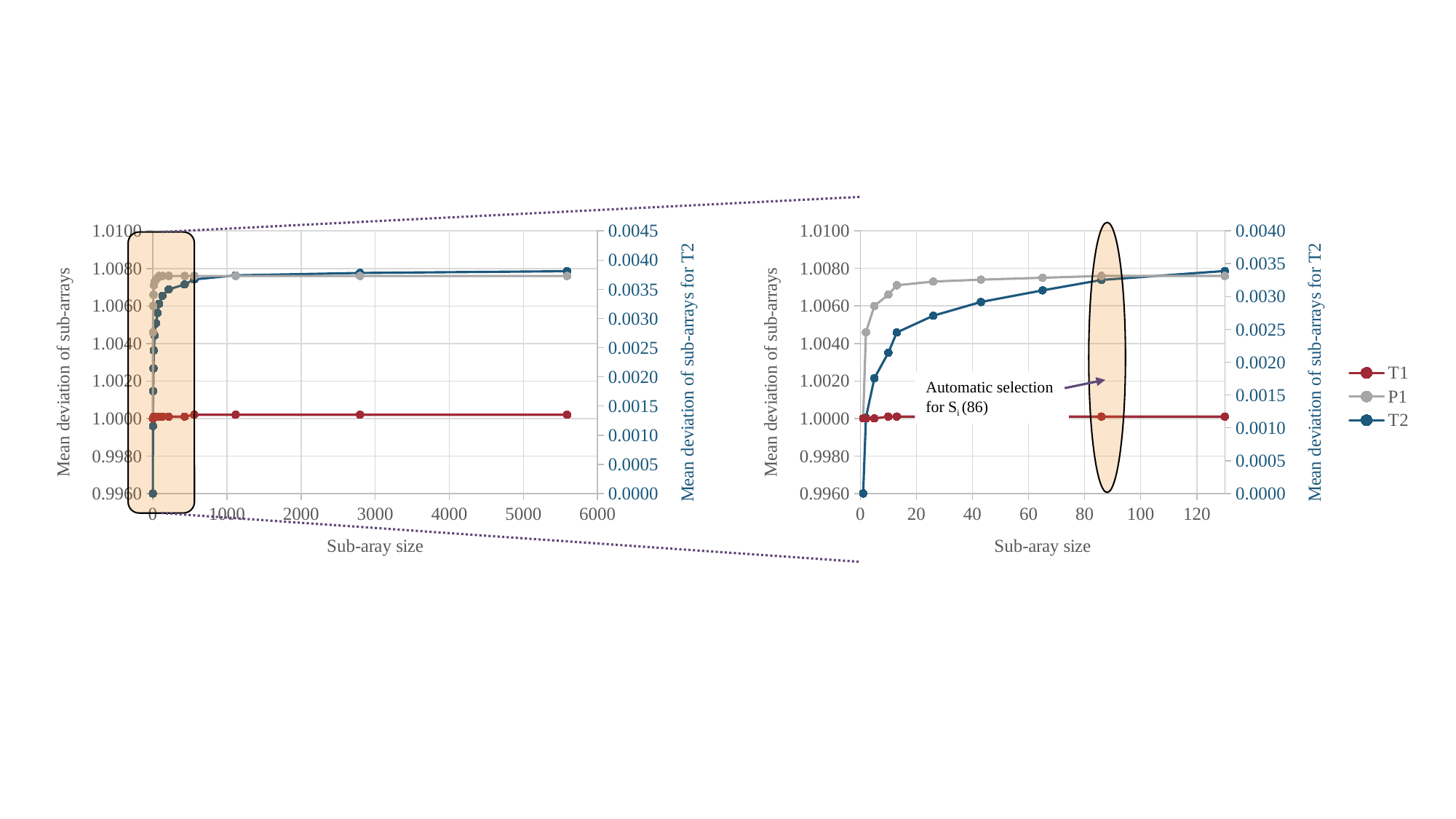
Which series are listed in the legend on the slide? T1, P1, T2 How many series does the legend on the slide list? 3 In the chart on the left, is the P1 value at sub-array size 5600 greater or less than 1.0060? greater In the chart on the right, does the T2 series rise or fall as sub-array size increases? rise What is the title of the x axis on the chart on the right? Sub-aray size In the chart on the right, is the T1 value at sub-array size 130 greater or less than 1.0020? less In the chart on the right, does the P1 series rise or fall as sub-array size increases? rise What kind of chart is the chart on the left of the slide? line chart In the chart on the right, what sub-array size does the annotation say is automatically selected for S_i? 86 In the chart on the right, is the P1 value at sub-array size 1 greater or less than 1.0060? less